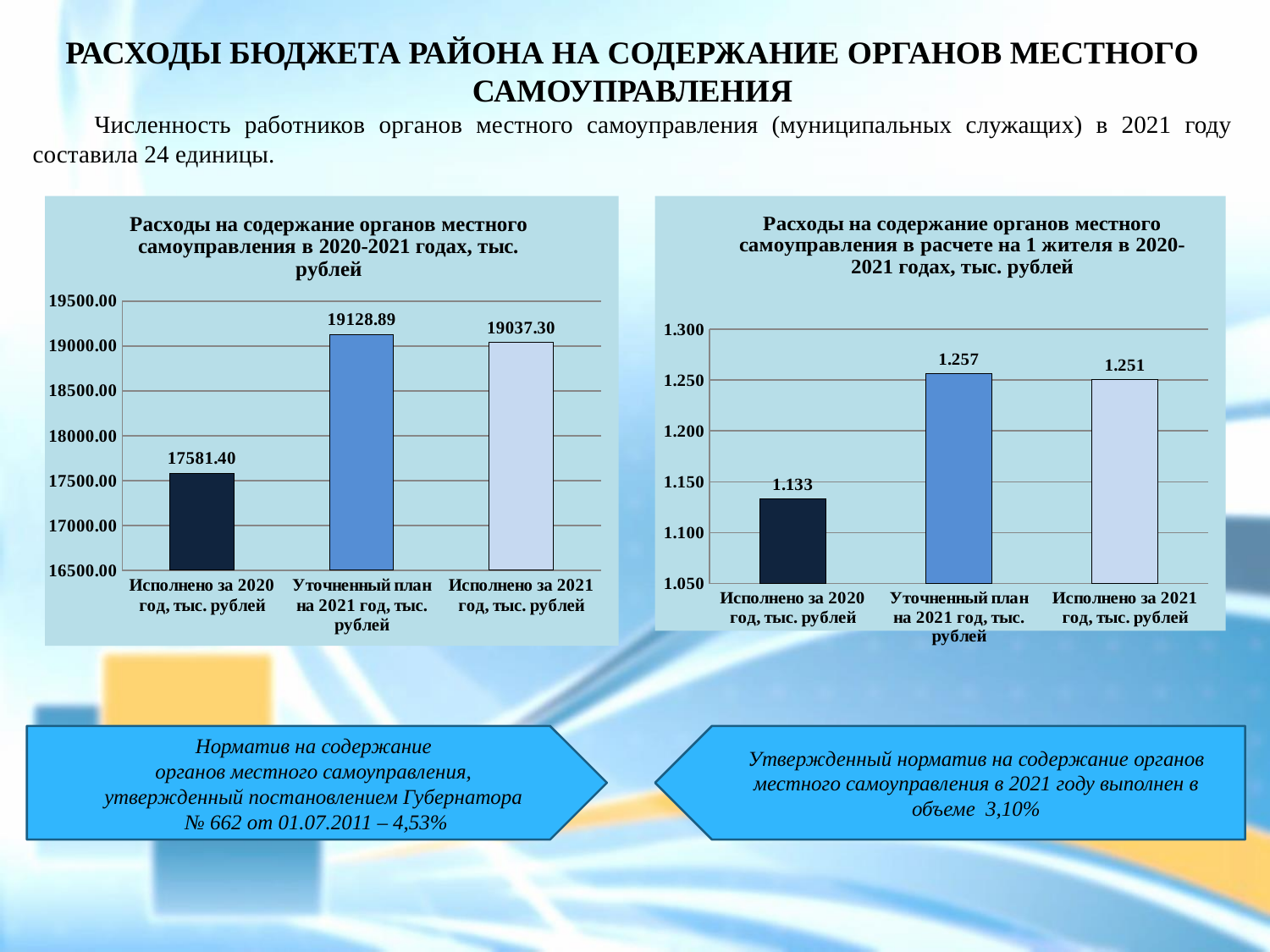
In the right chart (Расходы на содержание органов местного самоуправления в расчете на 1 жителя), what is the difference between Уточненный план на 2021 год and Исполнено за 2020 год? 0.124 In the left chart (Расходы на содержание органов местного самоуправления в 2020-2021 годах), what is the value for Исполнено за 2021 год? 19037.30 In the right chart (Расходы на содержание органов местного самоуправления в расчете на 1 жителя), which category has the highest value? Уточненный план на 2021 год, тыс. рублей In the left chart (Расходы на содержание органов местного самоуправления в 2020-2021 годах), which is larger: Уточненный план на 2021 год or Исполнено за 2021 год? Уточненный план на 2021 год, тыс. рублей In the left chart (Расходы на содержание органов местного самоуправления в 2020-2021 годах), what is the value for Уточненный план на 2021 год? 19128.89 In the right chart (Расходы на содержание органов местного самоуправления в расчете на 1 жителя), what is the value for Исполнено за 2021 год? 1.251 How many categories are shown in the right chart (Расходы на содержание органов местного самоуправления в расчете на 1 жителя)? 3 What type of chart is the left chart (Расходы на содержание органов местного самоуправления в 2020-2021 годах)? Bar chart In the left chart (Расходы на содержание органов местного самоуправления в 2020-2021 годах), which category has the lowest value? Исполнено за 2020 год, тыс. рублей In the left chart (Расходы на содержание органов местного самоуправления в 2020-2021 годах), what is the difference between Уточненный план на 2021 год and Исполнено за 2020 год? 1547.49 In the right chart (Расходы на содержание органов местного самоуправления в расчете на 1 жителя), what is the value for Исполнено за 2020 год? 1.133 In the left chart (Расходы на содержание органов местного самоуправления в 2020-2021 годах), what is the value for Исполнено за 2020 год? 17581.40